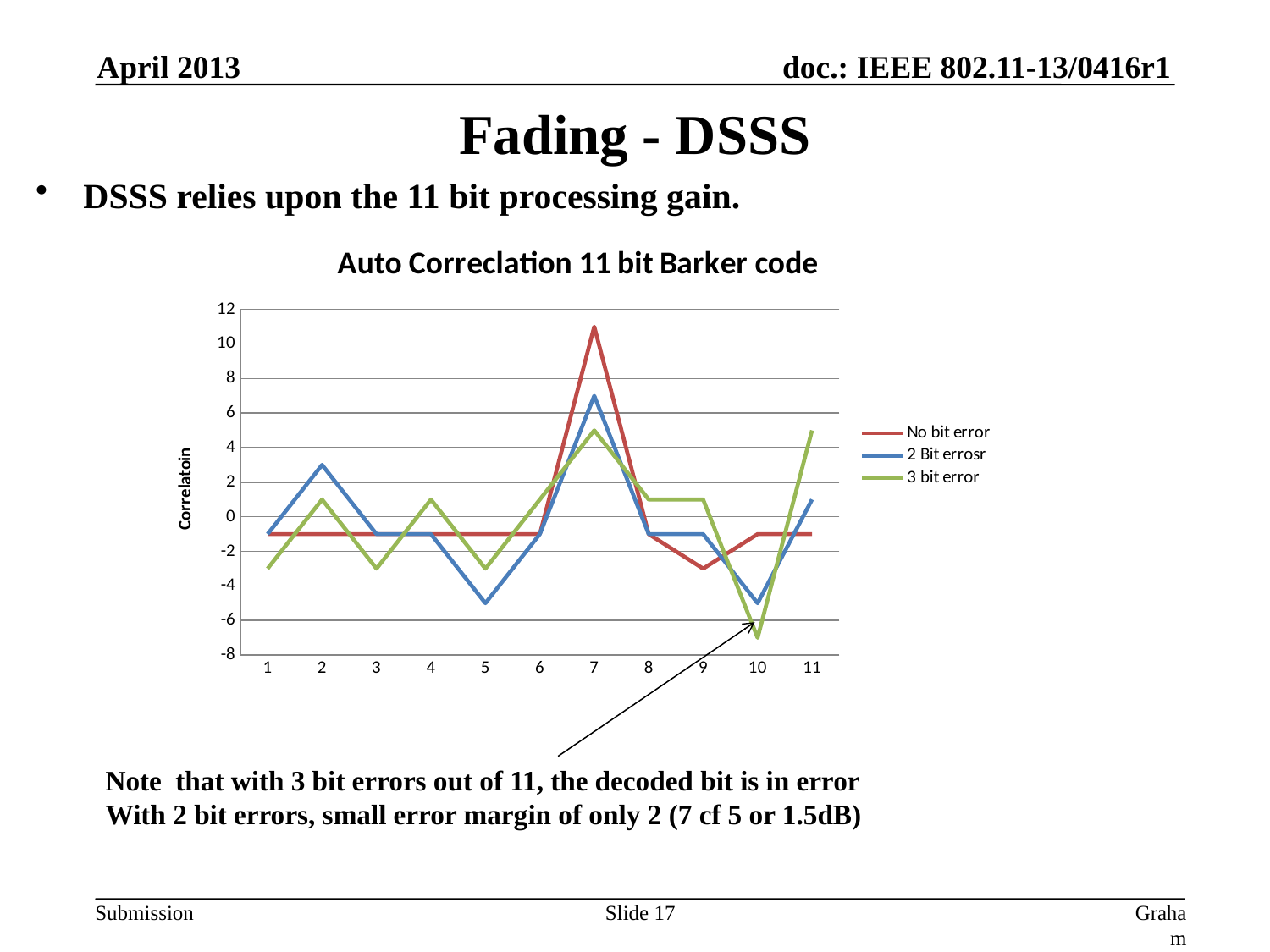
Is the value for 2 Bit errosr at point 5 greater or less than -4? less What is the title of the chart? Auto Correclation 11 bit Barker code At which x-axis point does the 3 bit error series reach its lowest value? 10 Is the value for No bit error at point 7 greater or less than 10? greater Is the value for 2 Bit errosr at point 7 greater or less than 6? greater How many points are plotted along the x axis? 11 Which series reaches the highest value at point 7? No bit error What kind of chart is shown on the slide? line chart How many series does the legend list? 3 At point 10, which is larger: 2 Bit errosr or 3 bit error? 2 Bit errosr What is the label on the vertical axis? Correlatoin